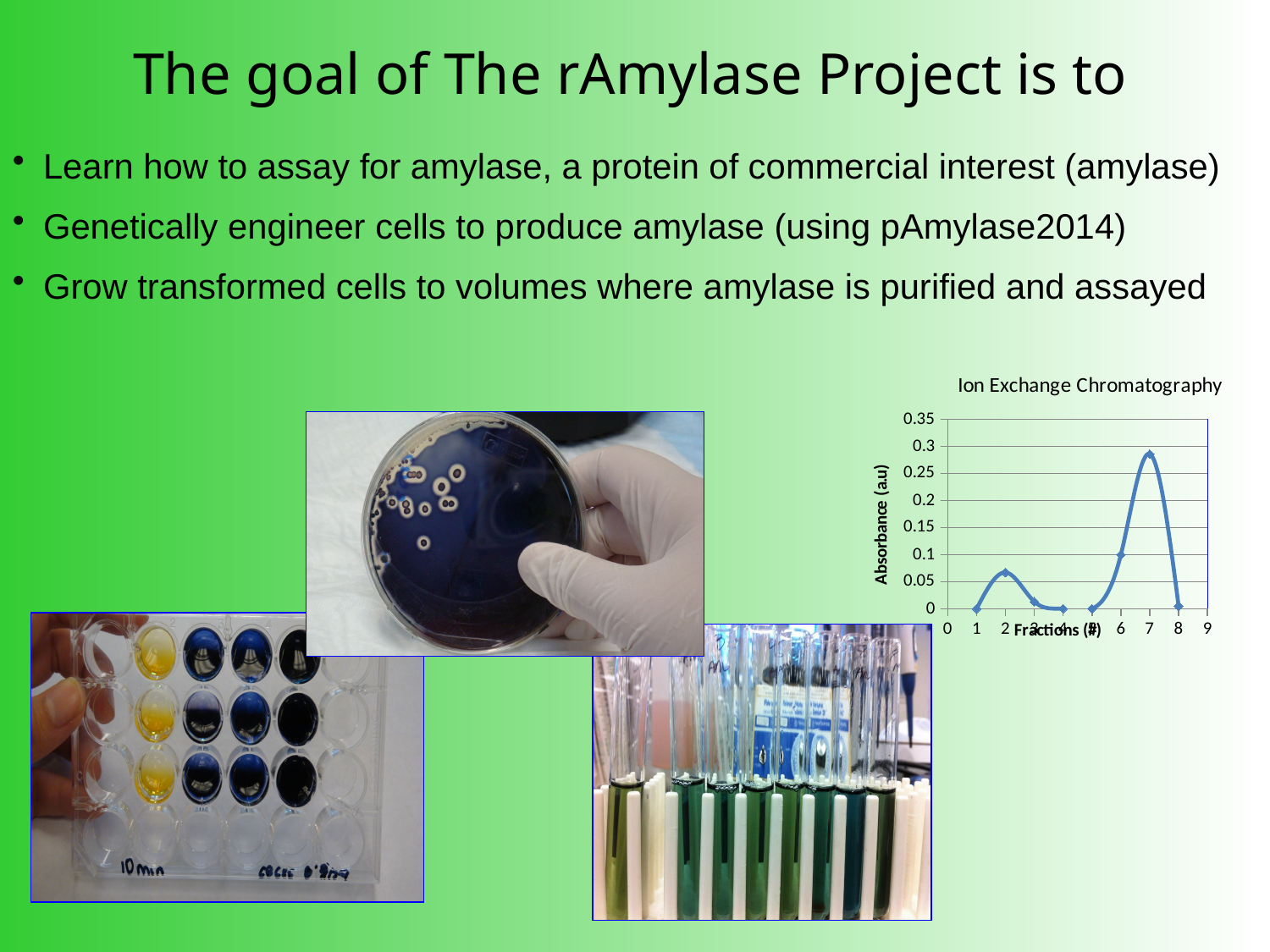
In the Ion Exchange Chromatography chart, is the absorbance for fraction 7 greater or less than 0.3? less In the Ion Exchange Chromatography chart, is the absorbance for fraction 7 greater or less than 0.25? greater In the Ion Exchange Chromatography chart, which fraction has the highest absorbance? 7 What is the label of the y axis in the Ion Exchange Chromatography chart? Absorbance (a.u) How many data points are plotted in the Ion Exchange Chromatography chart? 8 In the Ion Exchange Chromatography chart, which has the higher absorbance, fraction 6 or fraction 7? fraction 7 In the Ion Exchange Chromatography chart, which has the higher absorbance, fraction 2 or fraction 7? fraction 7 What is the title of the chart on the slide? Ion Exchange Chromatography In the Ion Exchange Chromatography chart, is the absorbance for fraction 2 greater or less than 0.1? less What kind of chart is the Ion Exchange Chromatography chart? line chart